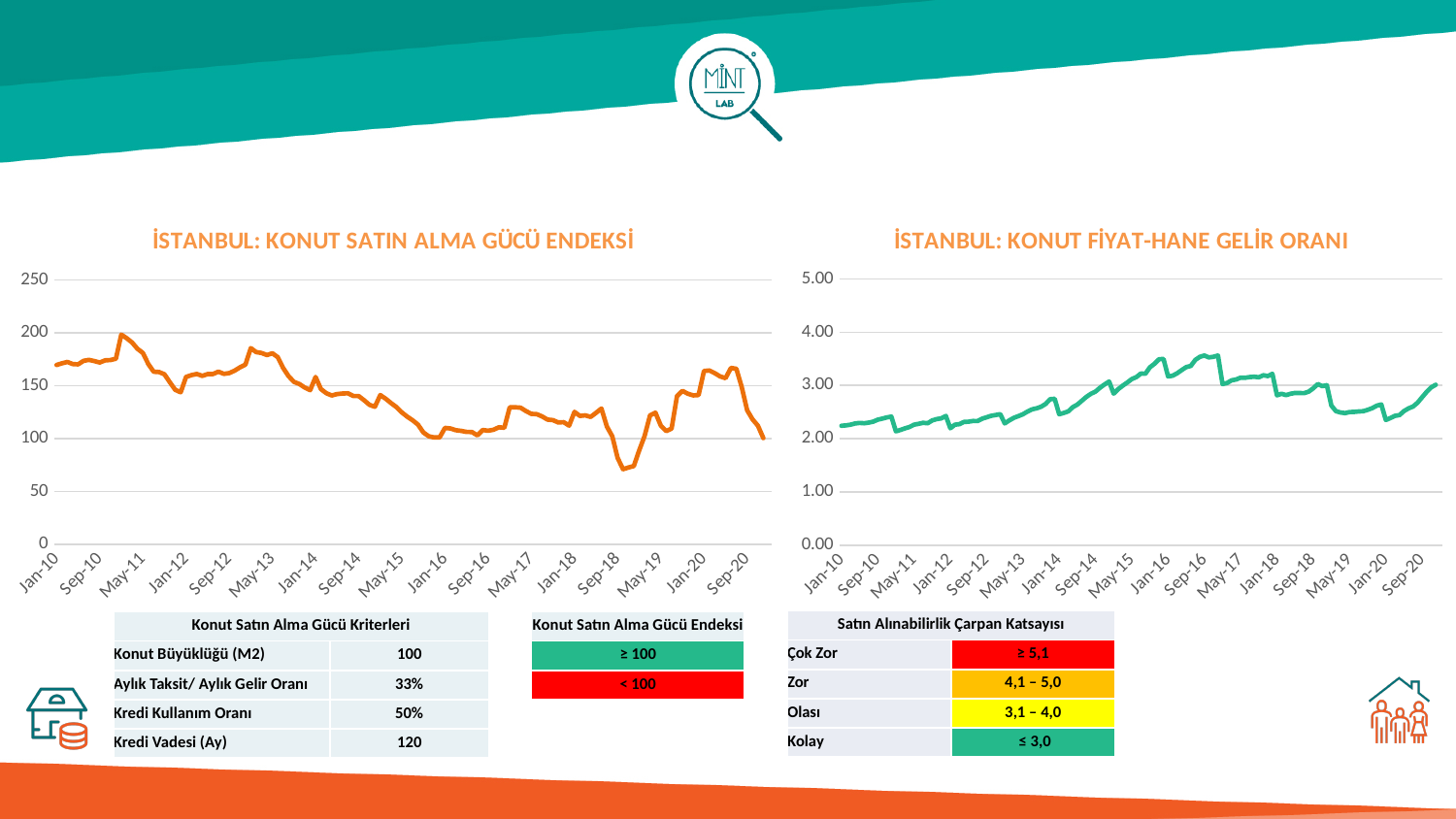
In the 'İSTANBUL: KONUT FİYAT-HANE GELİR ORANI' chart, is the value higher at Sep-16 or at Jan-20? Sep-16 What colour is the line in the 'İSTANBUL: KONUT SATIN ALMA GÜCÜ ENDEKSİ' chart? orange In the 'İSTANBUL: KONUT SATIN ALMA GÜCÜ ENDEKSİ' chart, is the value at Jan-10 greater or less than 150? greater In the 'İSTANBUL: KONUT SATIN ALMA GÜCÜ ENDEKSİ' chart, is the value at Sep-18 greater or less than 100? less What kind of chart is the 'İSTANBUL: KONUT FİYAT-HANE GELİR ORANI' chart? line chart In the 'İSTANBUL: KONUT FİYAT-HANE GELİR ORANI' chart, does the line overall rise or fall from Jan-10 to Sep-20? rise In the 'İSTANBUL: KONUT SATIN ALMA GÜCÜ ENDEKSİ' chart, does the line overall rise or fall from Jan-10 to Sep-20? fall In the 'İSTANBUL: KONUT SATIN ALMA GÜCÜ ENDEKSİ' chart, is the value higher at Jan-10 or at Sep-20? Jan-10 In the 'İSTANBUL: KONUT FİYAT-HANE GELİR ORANI' chart, is the value at Jan-20 greater or less than 3.00? less What kind of chart is the 'İSTANBUL: KONUT SATIN ALMA GÜCÜ ENDEKSİ' chart? line chart What is the highest value shown on the y axis of the 'İSTANBUL: KONUT FİYAT-HANE GELİR ORANI' chart? 5.00